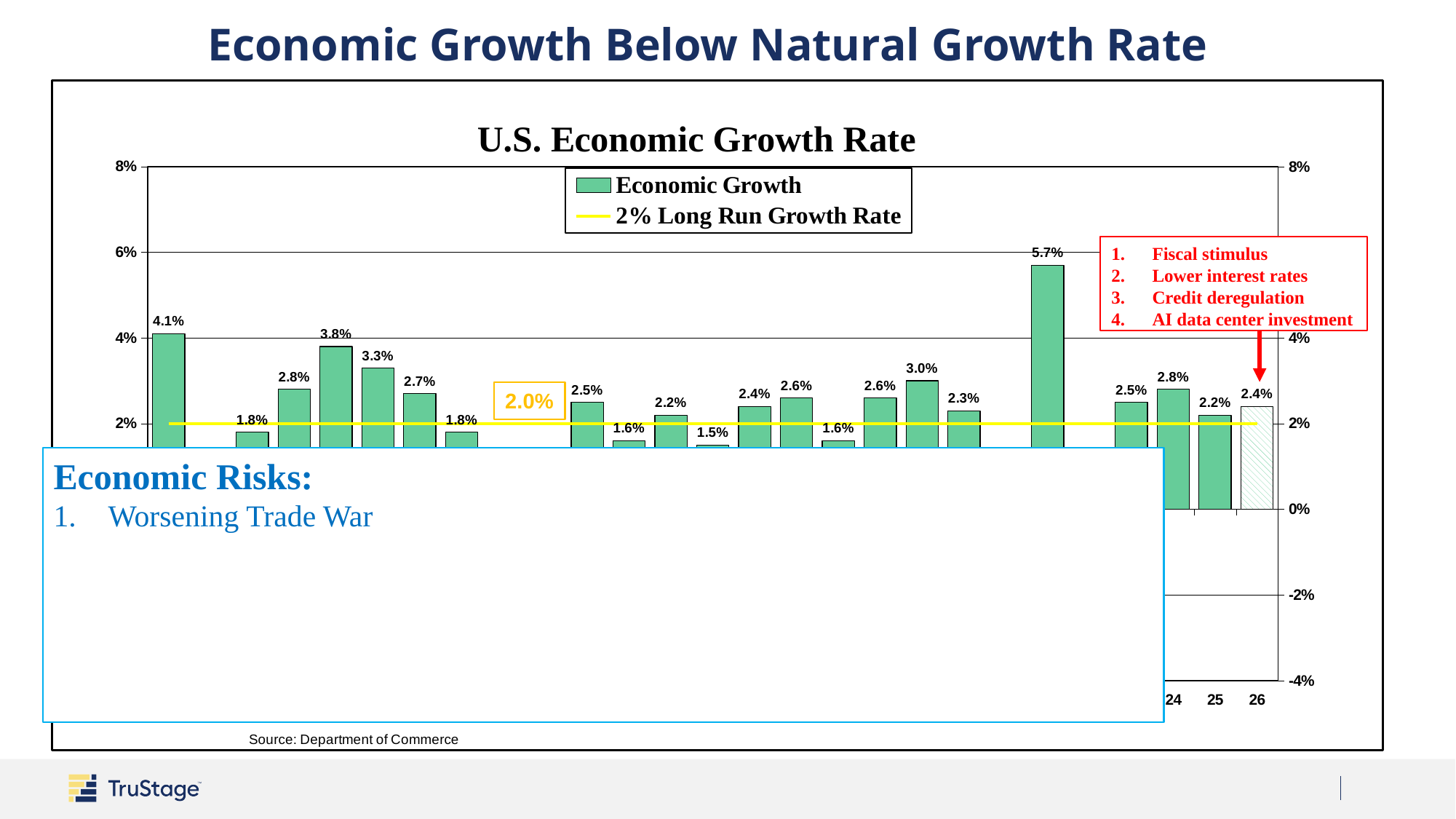
Which has a higher economic growth rate, 24 or 25? 24 What is the title of the chart? U.S. Economic Growth Rate What is the economic growth rate shown for 25? 2.2% What value does the yellow horizontal line on the chart represent? 2% Long Run Growth Rate What is the highest economic growth rate value labeled on the chart? 5.7% How many entries does the chart legend list? 2 What is the economic growth rate shown for 26? 2.4% What is the difference between the economic growth rate for 26 and for 25? 0.2% What is the economic growth rate shown for 24? 2.8% Is the economic growth rate for 25 greater or less than 4%? less What type of chart is shown on the slide? combination bar and line chart